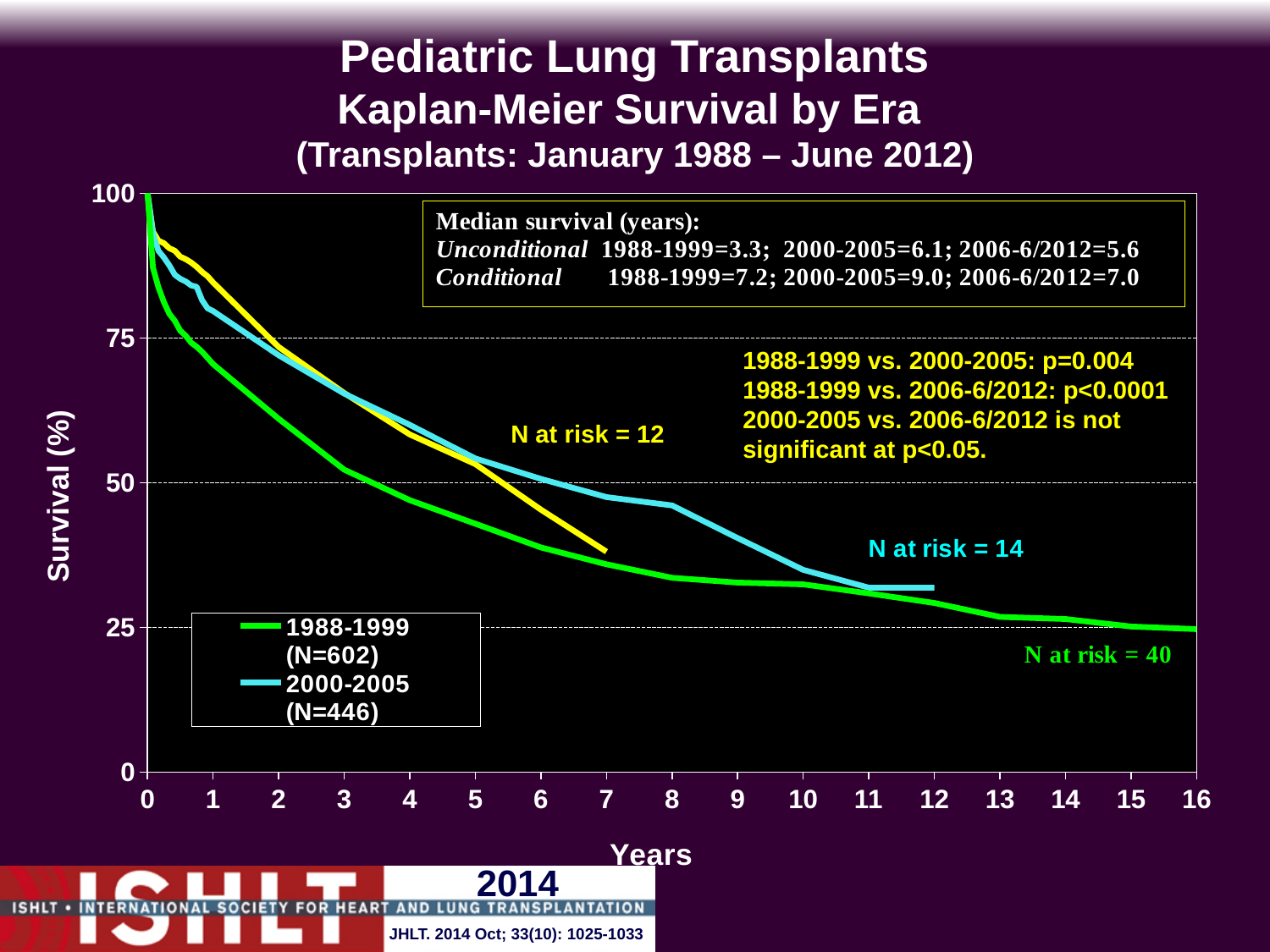
Is the survival value for the 2000-2005 curve at 1 year greater or less than 75? greater What is the unconditional median survival in years for the 2000-2005 era? 6.1 Is the survival value for the 1988-1999 curve at 5 years greater or less than 50? less What is the N at risk shown for the 1988-1999 era? 40 Which era has the highest unconditional median survival? 2000-2005 What is the difference in unconditional median survival between the 2000-2005 era and the 1988-1999 era? 2.8 years What is the conditional median survival in years for the 1988-1999 era? 7.2 What kind of chart is shown on the slide? line chart Do the survival curves rise or fall as years increase? fall How many series does the legend list? 2 What is the N at risk shown next to the cyan 2000-2005 curve? 14 Which era has the larger conditional median survival, 2000-2005 or 2006-6/2012? 2000-2005